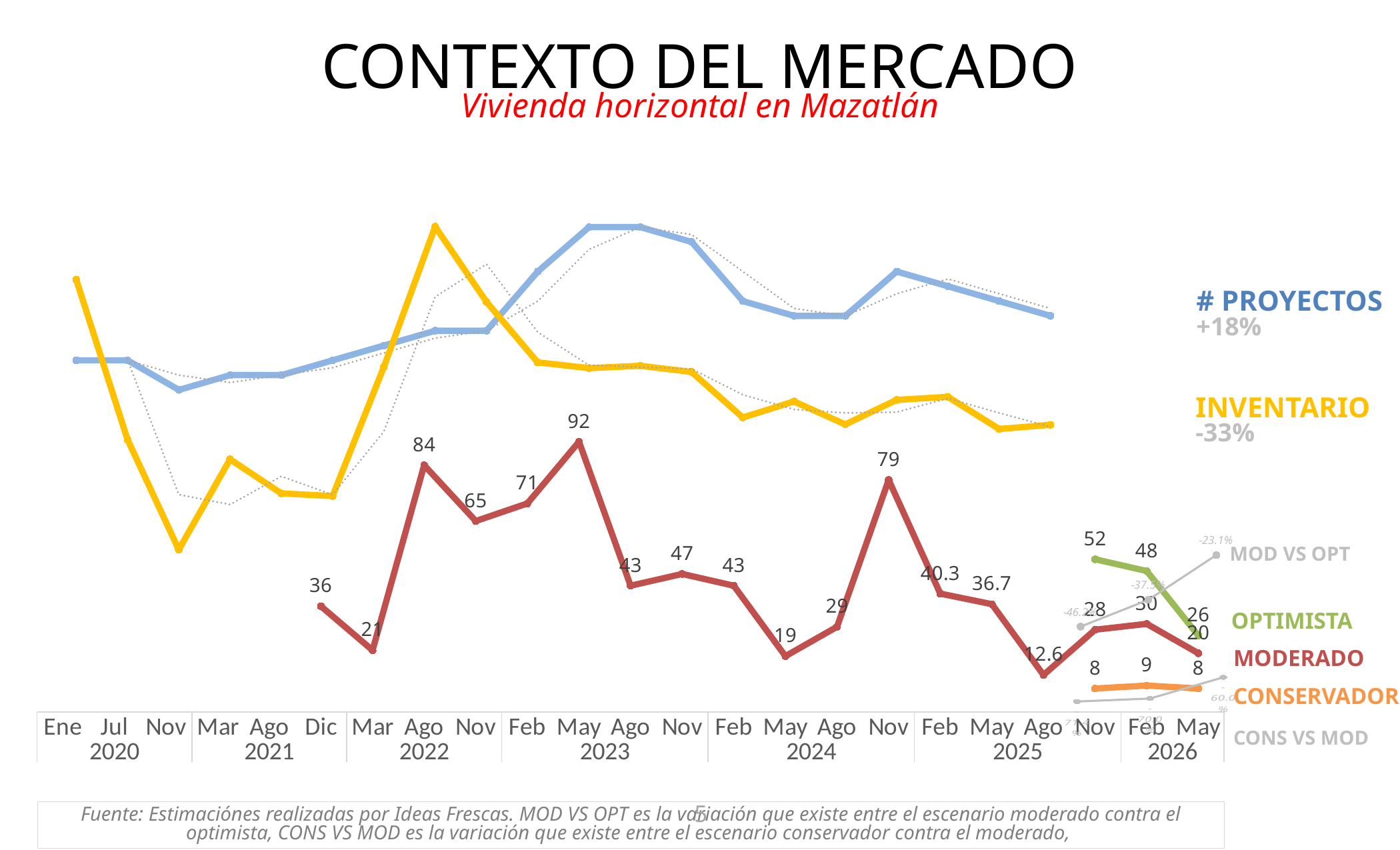
In which month does the MODERADO series reach its highest value? May 2023 What is the OPTIMISTA value for Nov 2025? 52 What is the CONSERVADOR value for Feb 2026? 9 What is the difference between the OPTIMISTA and MODERADO values in May 2026? 6 What is the difference between the MODERADO values for Nov 2024 and Feb 2025? 38.7 What is the MODERADO value for May 2023? 92 How many data points does the OPTIMISTA series have? 3 Which is larger: the MODERADO value for Ago 2022 or for Nov 2024? Ago 2022 What percentage change is shown next to the INVENTARIO label? -33% Does the OPTIMISTA series rise or fall from Nov 2025 to May 2026? fall In which month does the MODERADO series reach its lowest value? Ago 2025 What kind of chart is shown on the slide? line chart